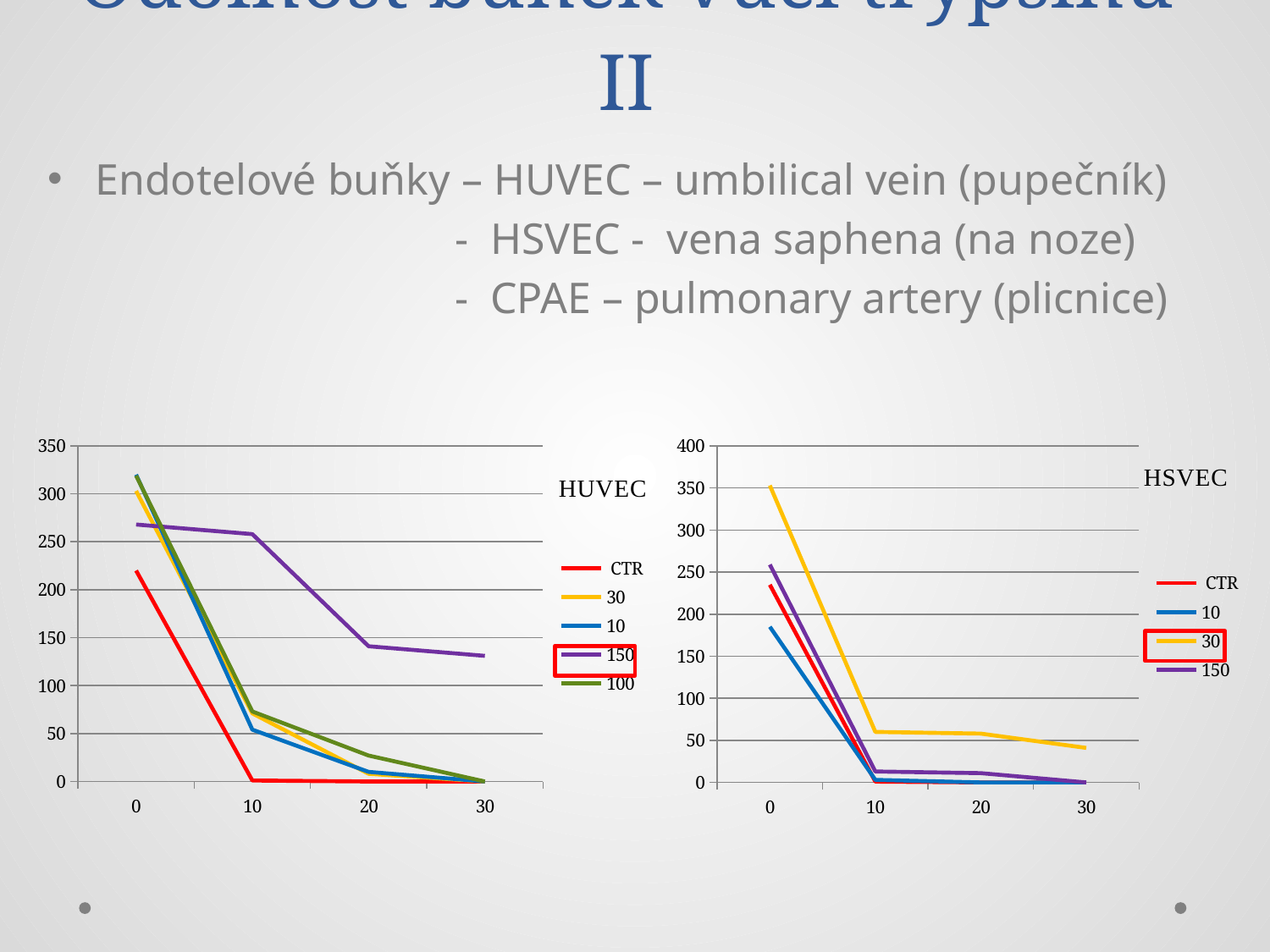
In the HUVEC chart, is the value of the 150 series at x = 20 greater or less than 100? greater In the HUVEC chart, which series has the highest value at x = 30? 150 What kind of chart is the HUVEC chart on the left? line chart In the HUVEC chart, which series has the lowest value at x = 0? CTR In the HSVEC chart, which series has the lowest value at x = 0? 10 In the HSVEC chart, is the value of the 10 series at x = 0 greater or less than 200? less How many series does the legend of the HUVEC chart list? 5 In the HSVEC chart, is the value of the 30 series at x = 0 greater or less than 300? greater How many series does the legend of the HSVEC chart list? 4 In the HSVEC chart, which series has the highest value at x = 0? 30 In the HUVEC chart, does the CTR series rise or fall from x = 0 to x = 10? fall How many x-axis points are plotted in the HSVEC chart? 4